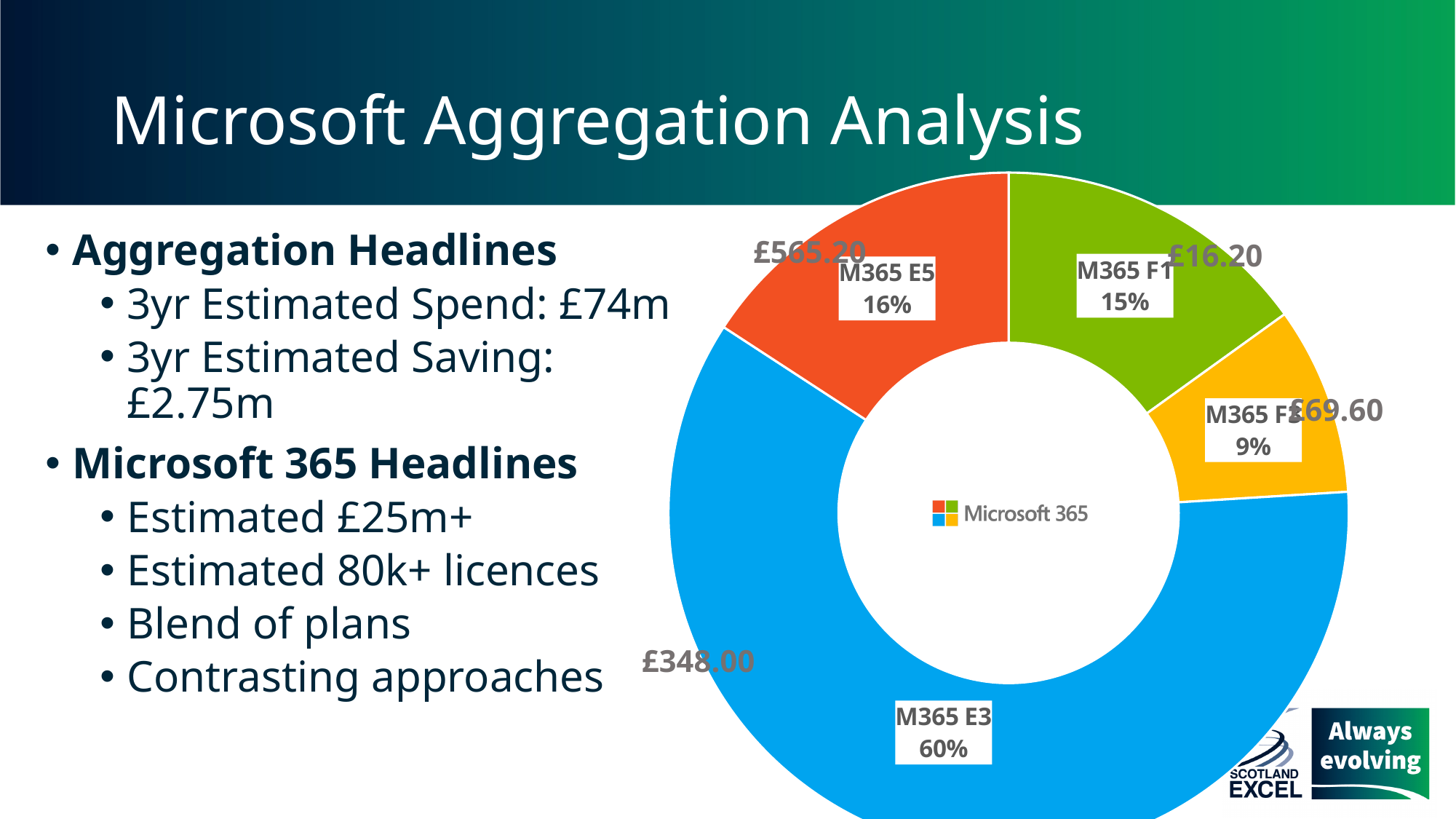
Which segment has the largest share of the doughnut chart? M365 E3 What text appears in the centre of the doughnut chart? Microsoft 365 What kind of chart is shown on the slide? doughnut chart What share of the doughnut chart does M365 E3 have? 60% Which has the larger share, M365 E3 or M365 E5? M365 E3 What share of the doughnut chart does M365 E5 have? 16% What price label is shown next to the M365 E5 segment? £565.20 What percentage is shown for the yellow segment of the doughnut chart? 9% How many segments does the doughnut chart have? 4 What price label is shown next to the M365 E3 segment? £348.00 What price label is shown next to the M365 F1 segment? £16.20